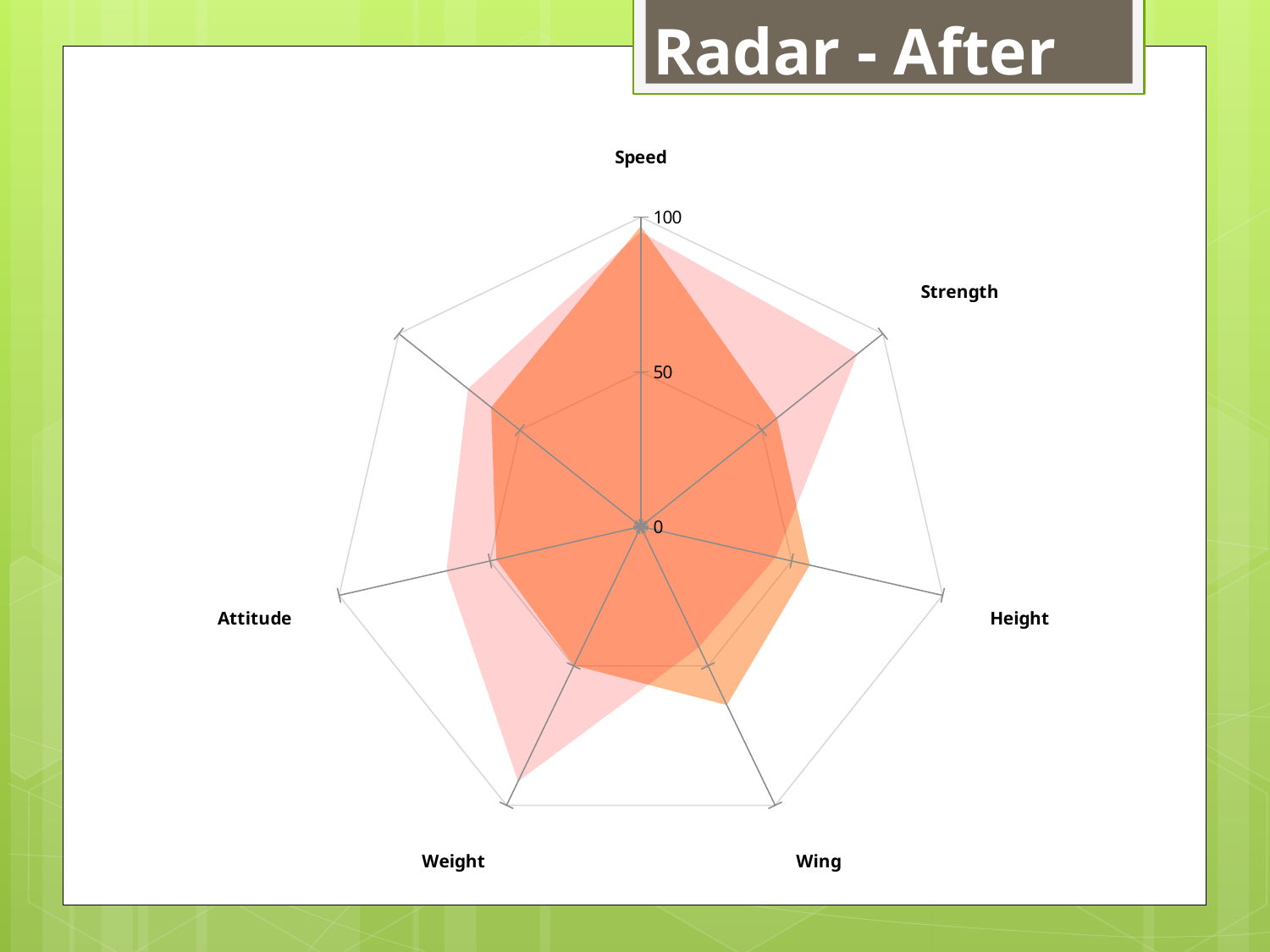
What is the title of the slide containing the radar chart? Radar - After Is the value for Attitude for the lighter pink series greater or less than 50? greater For Weight, which series has the larger value: the darker orange series or the lighter pink series? The lighter pink series What kind of chart is shown on the slide? Radar chart Which category has the highest value for the darker orange series? Speed What is the highest tick value shown on the radar chart's axis? 100 Is the value for Strength for the lighter pink series greater or less than 50? greater How many axes (spokes) does the radar chart have? 7 For Strength, which series has the larger value: the darker orange series or the lighter pink series? The lighter pink series Is the value for Weight for the lighter pink series greater or less than 50? greater For the lighter pink series, which is larger: the value for Strength or the value for Height? Strength